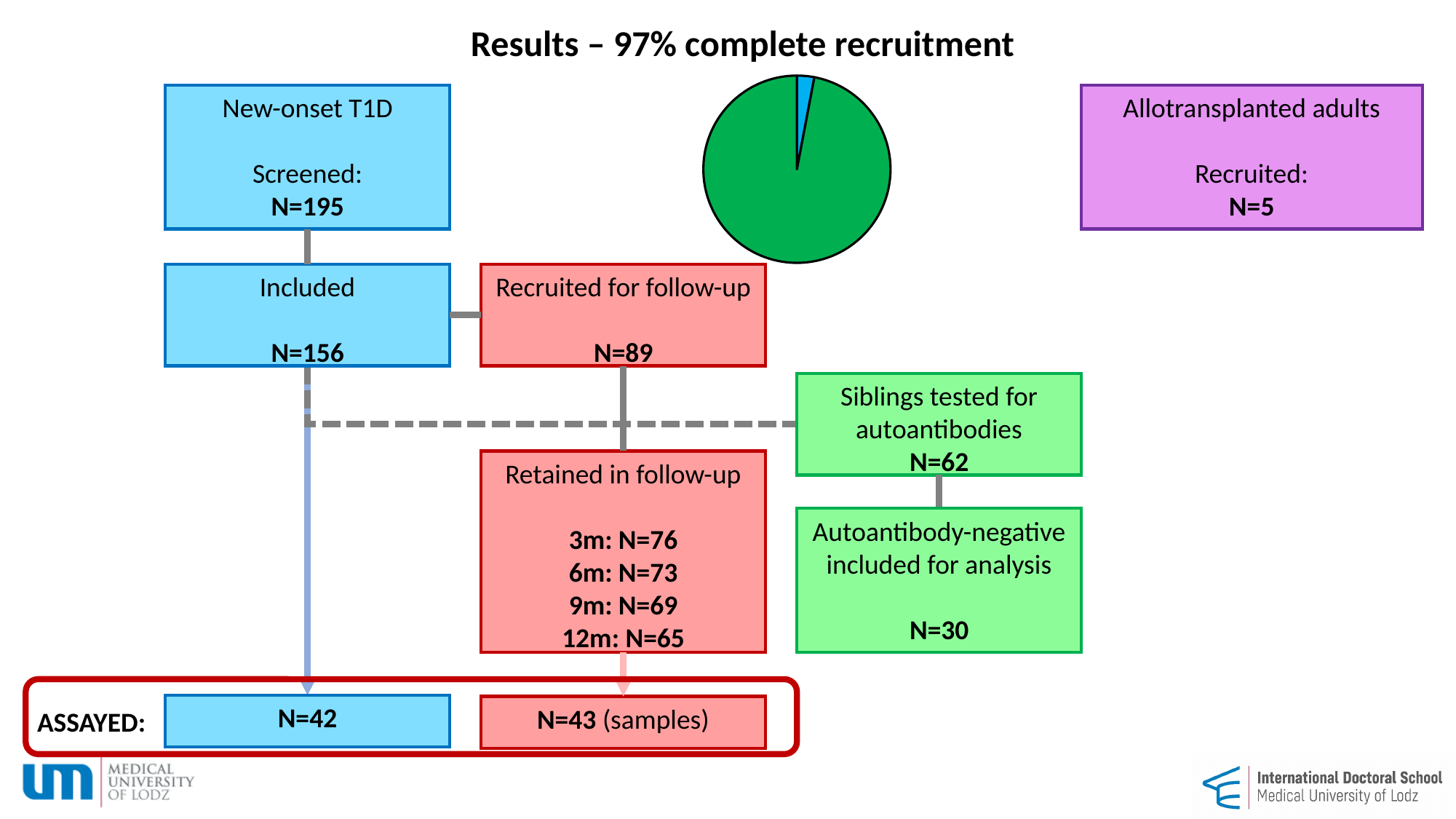
Which colour slice is the largest in the pie chart? green Does the pie chart display a legend? No What kind of chart is shown at the top centre of the slide? pie chart How many slices does the pie chart have? 2 What two colours are used for the slices of the pie chart? green and blue Does the green slice of the pie chart cover more or less than half of the pie? more Which colour slice is the smallest in the pie chart? blue Which slice of the pie chart is larger, the green one or the blue one? green